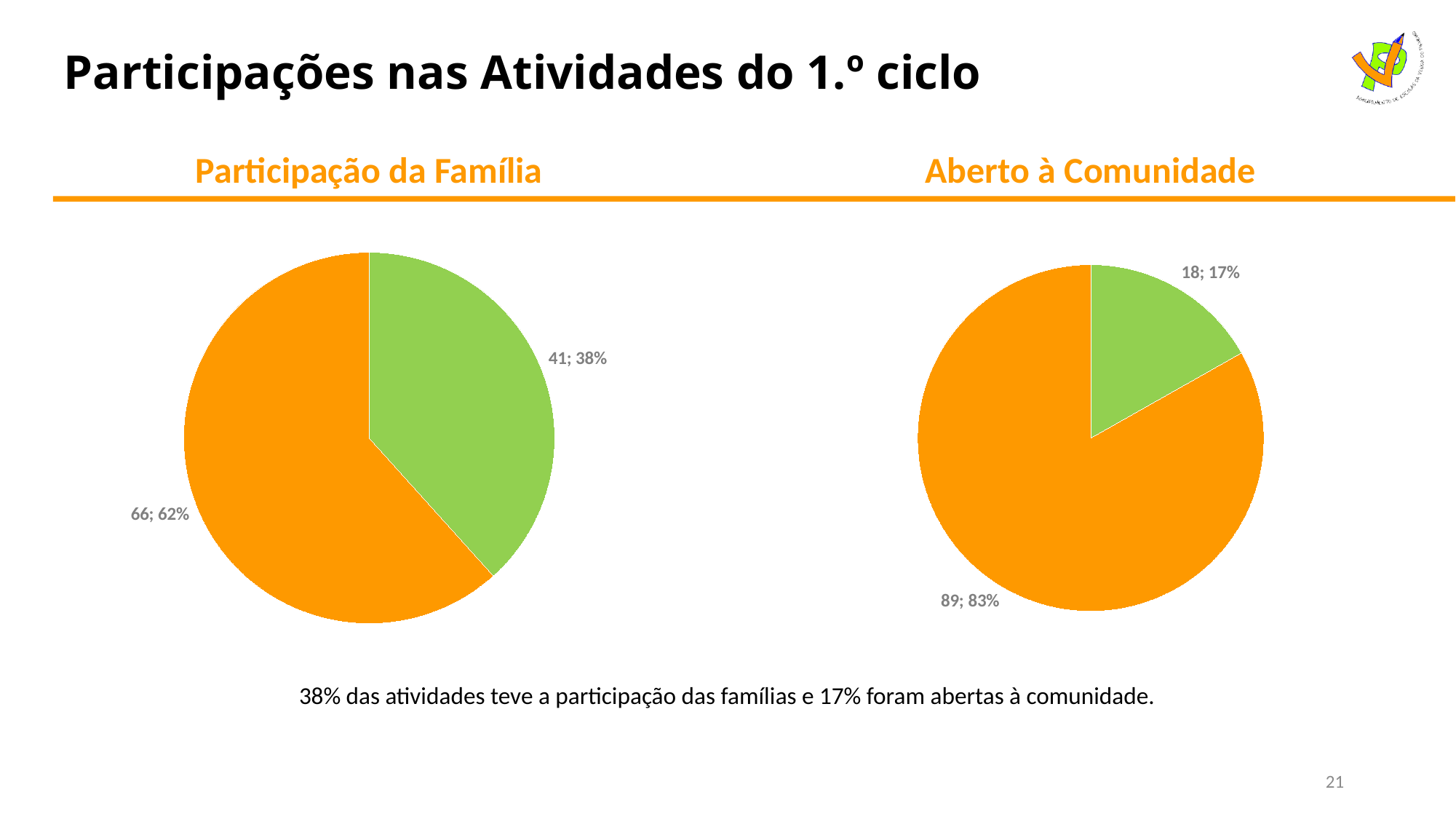
In the "Participação da Família" pie chart, what is the difference between the counts of the orange and green slices? 25 In the "Aberto à Comunidade" pie chart, what value is labelled on the green slice? 18; 17% In the "Aberto à Comunidade" pie chart, what value is labelled on the orange slice? 89; 83% In the "Aberto à Comunidade" pie chart, what share of the pie does the orange slice represent? 83% In the "Aberto à Comunidade" pie chart, which slice is the smallest? the green slice (18; 17%) In the "Aberto à Comunidade" pie chart, what is the total of the two slice counts? 107 How many slices does the "Aberto à Comunidade" pie chart have? 2 In the "Participação da Família" pie chart, what value is labelled on the green slice? 41; 38% What kind of chart is used under "Participação da Família"? pie chart In the "Participação da Família" pie chart, which slice is larger, the orange one or the green one? the orange one In the "Participação da Família" pie chart, what value is labelled on the orange slice? 66; 62% In the "Participação da Família" pie chart, what share of the pie does the green slice represent? 38%